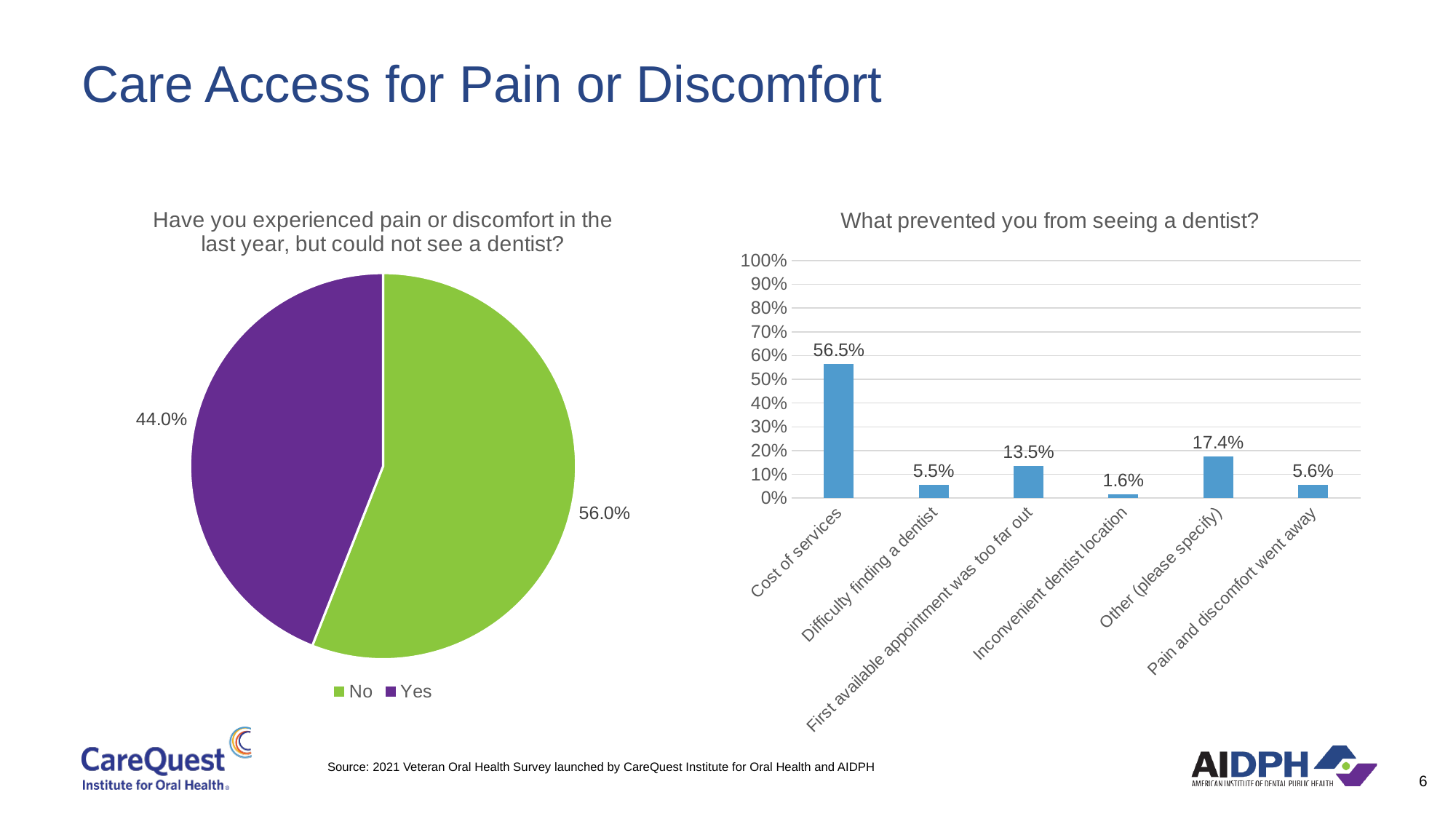
In the chart 'What prevented you from seeing a dentist?', which category has the highest value? Cost of services In the pie chart 'Have you experienced pain or discomfort in the last year, but could not see a dentist?', what share of respondents answered No? 56.0% In the pie chart on the left, how many entries does the legend list? 2 In the chart 'What prevented you from seeing a dentist?', what is the value for Inconvenient dentist location? 1.6% In the pie chart on the left, which answer has the larger slice, No or Yes? No In the chart 'What prevented you from seeing a dentist?', which category has the lowest value? Inconvenient dentist location What kind of chart is 'What prevented you from seeing a dentist?'? Bar chart In the chart 'What prevented you from seeing a dentist?', what is the difference between Other (please specify) and First available appointment was too far out? 3.9% In the pie chart 'Have you experienced pain or discomfort in the last year, but could not see a dentist?', what share of respondents answered Yes? 44.0% In the chart 'What prevented you from seeing a dentist?', how many categories are shown on the x axis? 6 In the chart 'What prevented you from seeing a dentist?', what is the value for Cost of services? 56.5% In the pie chart on the left, what colour is the Yes slice? Purple